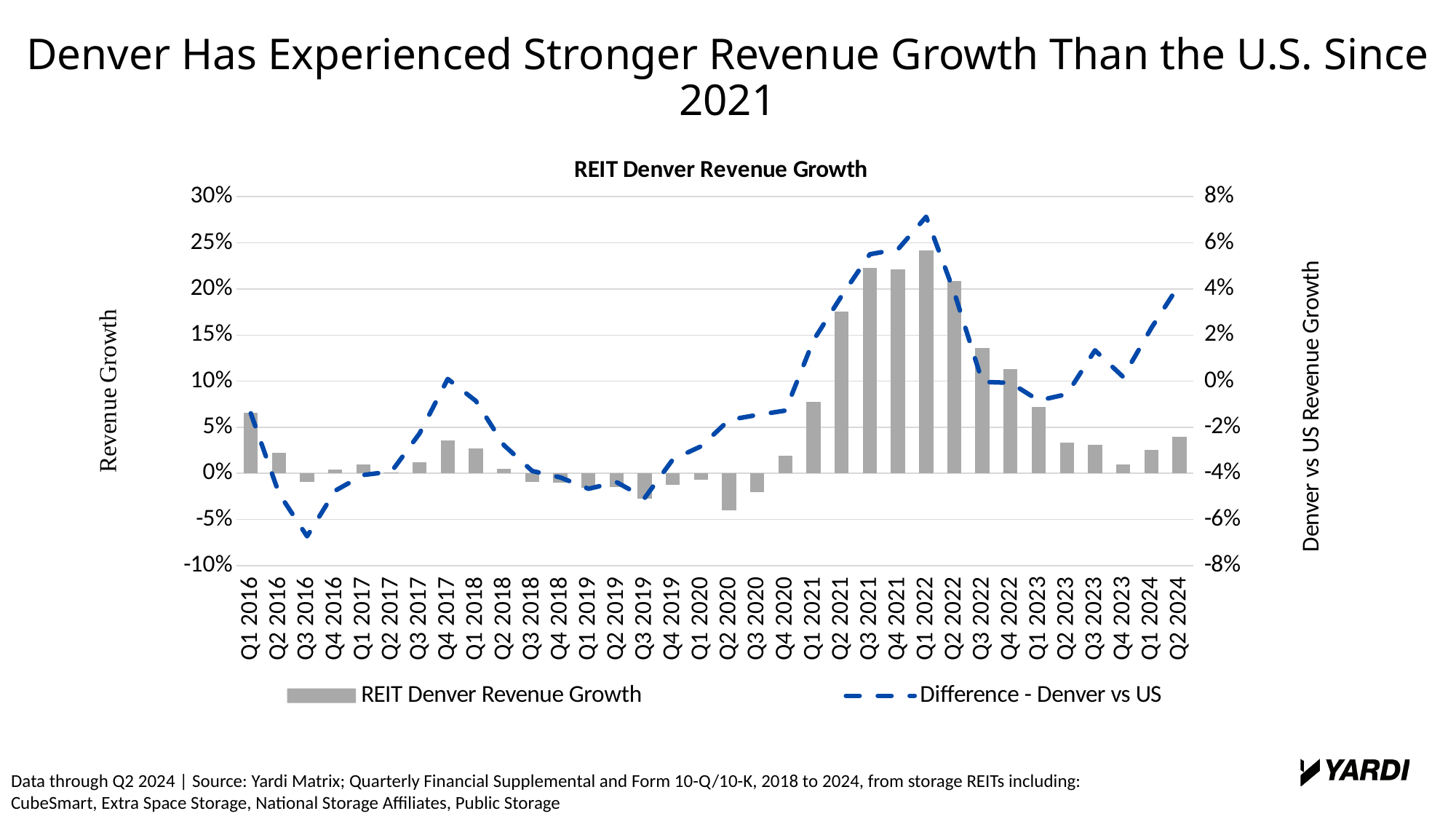
Which quarter has higher REIT Denver Revenue Growth, Q1 2022 or Q2 2022? Q1 2022 Is the REIT Denver Revenue Growth value for Q2 2020 greater or less than 0%? less Is the REIT Denver Revenue Growth value for Q1 2021 greater or less than 5%? greater In which quarter is REIT Denver Revenue Growth highest? Q1 2022 In which quarter is REIT Denver Revenue Growth lowest? Q2 2020 Is the REIT Denver Revenue Growth value for Q3 2021 greater or less than 20%? greater What type of chart is shown on the slide? Combined bar and line chart How many series does the legend list? 2 In which quarter does the Difference - Denver vs US line reach its lowest point? Q3 2016 How many quarters are plotted along the x axis? 34 Do the REIT Denver Revenue Growth bars rise or fall from Q1 2022 to Q1 2023? fall What is the title of the chart? REIT Denver Revenue Growth